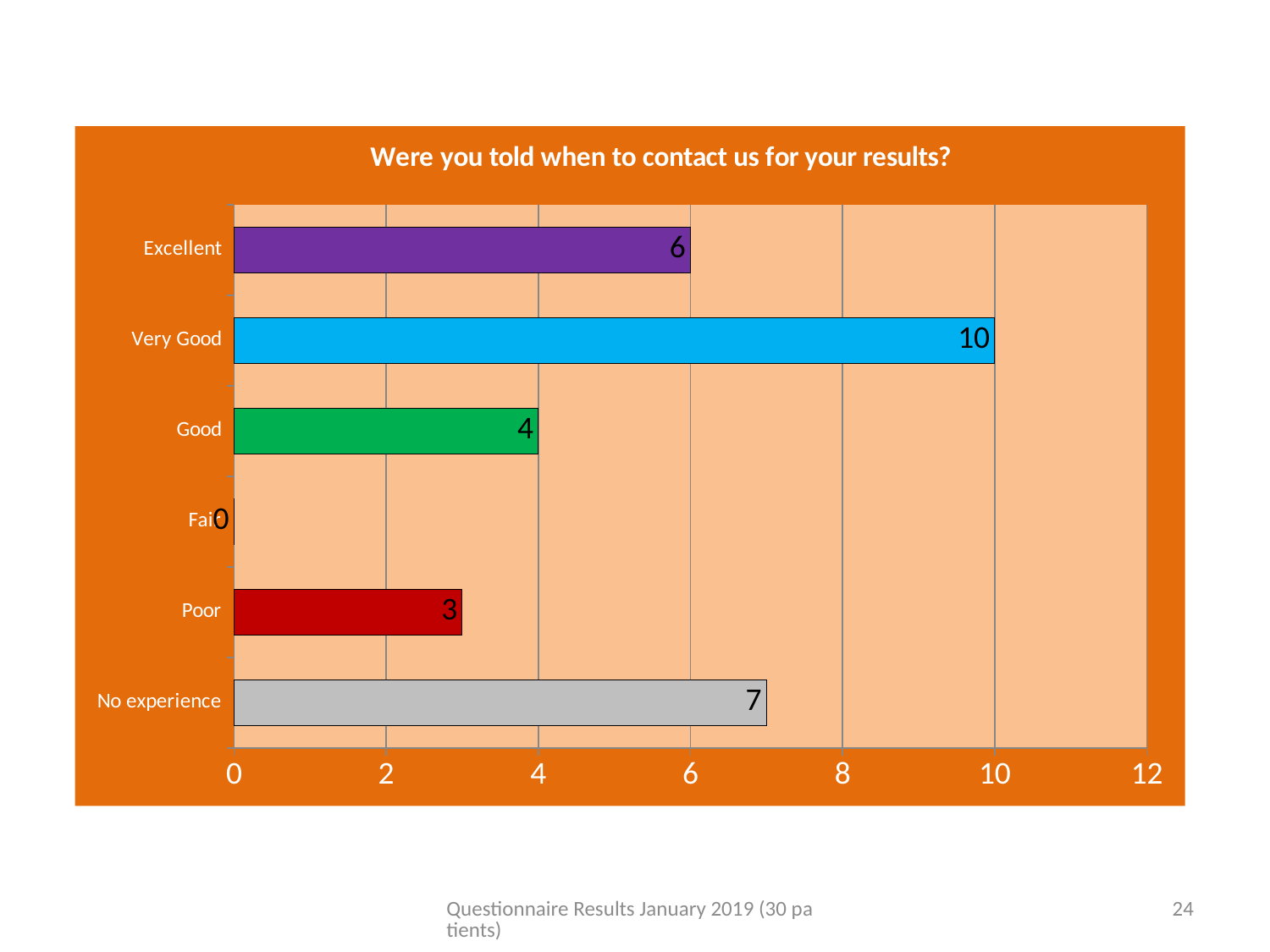
What is the title of the chart? Were you told when to contact us for your results? What colour is the bar for Very Good? blue Which is larger, the value for No experience or the value for Good? No experience What is the value for No experience? 7 What is the difference between the values for Very Good and Excellent? 4 How many categories are shown in the chart? 6 Which category has the lowest value? Fair Which category has the highest value? Very Good What kind of chart is shown on the slide? bar chart Is the value for Excellent greater or less than 8? less What is the value for Poor? 3 What is the value for Very Good? 10